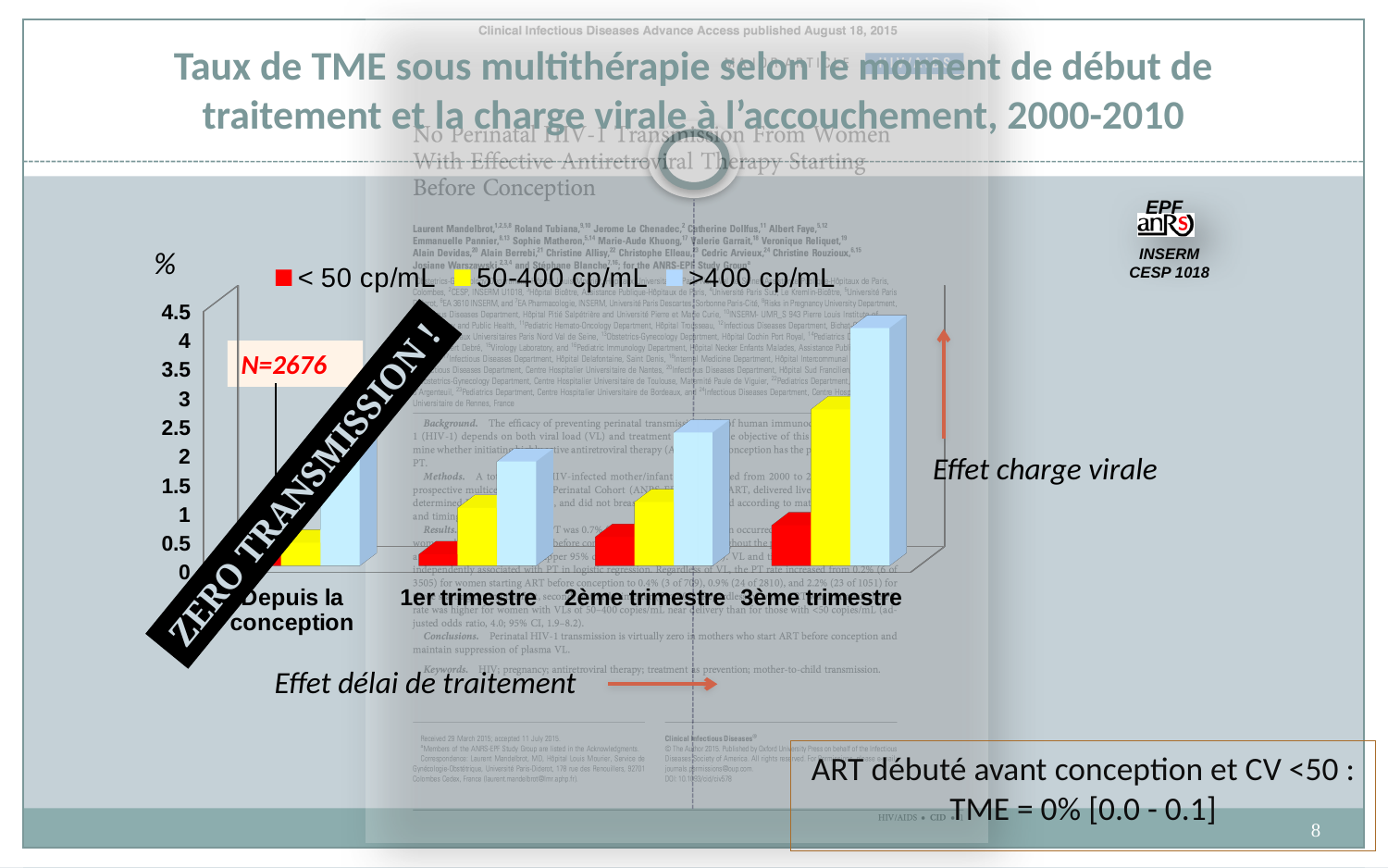
Is the value for < 50 cp/mL in the 1er trimestre category greater or less than 1? less How many categories are shown along the x axis of the chart? 4 Which series is shown in red in the chart legend? < 50 cp/mL What unit is indicated on the vertical axis of the chart? % Within the 3ème trimestre category, which series has the highest bar? >400 cp/mL Is the value for >400 cp/mL in the 3ème trimestre category greater or less than 3? greater Which is larger: the 50-400 cp/mL value for 3ème trimestre or for 1er trimestre? 3ème trimestre What kind of chart is shown on the slide? bar chart Is the value for 50-400 cp/mL in the 3ème trimestre category greater or less than 2? greater Do the < 50 cp/mL values rise or fall from Depuis la conception to 3ème trimestre? rise What is the TME rate for women who started ART before conception with a viral load < 50 cp/mL? 0% How many series does the chart legend list? 3